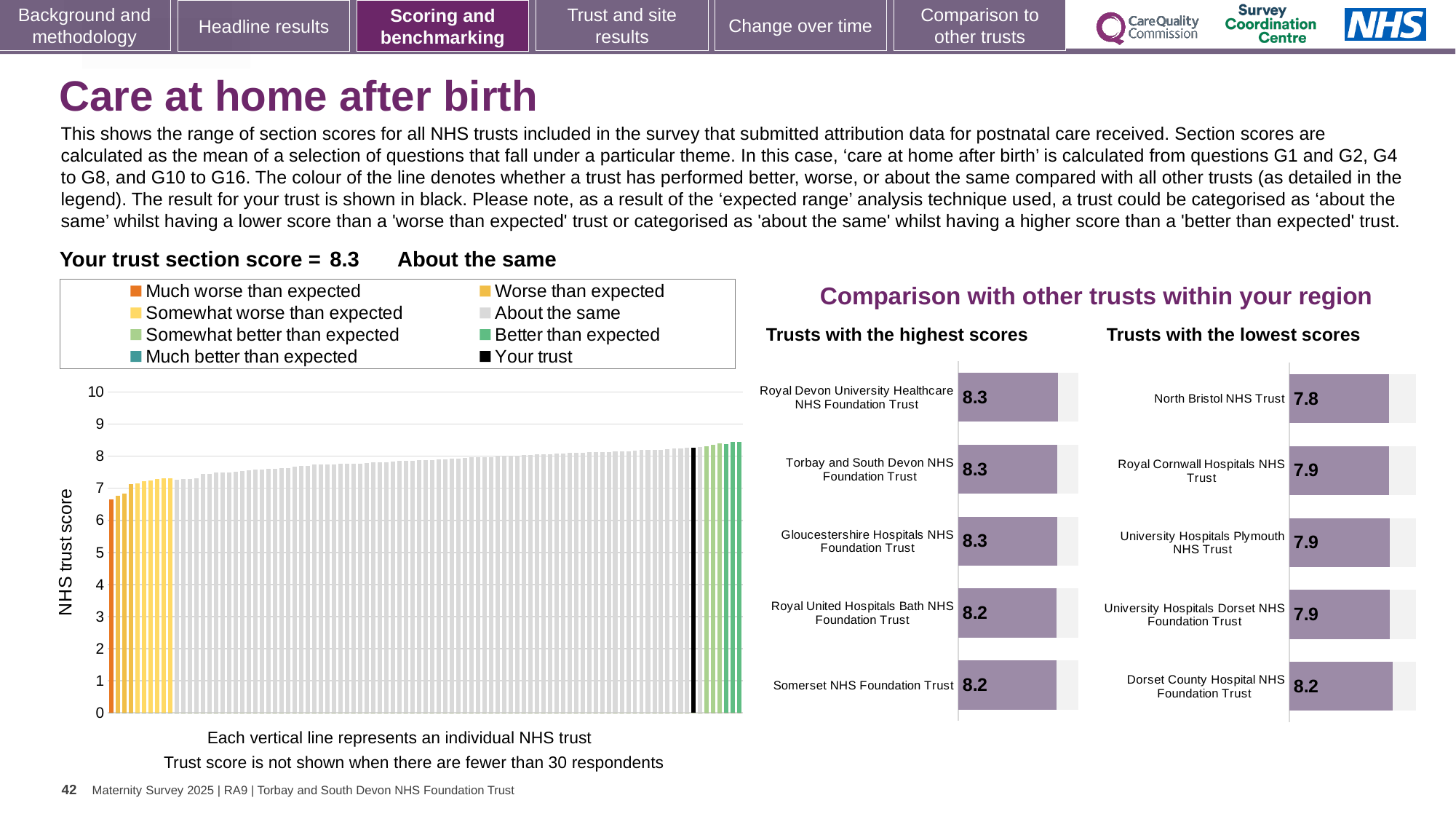
In the 'Trusts with the highest scores' chart, what is the score for Royal United Hospitals Bath NHS Foundation Trust? 8.2 How many entries does the legend above the large chart on the left list? 8 In the 'Trusts with the lowest scores' chart, what is the difference between the scores of Dorset County Hospital NHS Foundation Trust and North Bristol NHS Trust? 0.4 How many trusts are listed in the 'Trusts with the highest scores' chart? 5 In the 'Trusts with the lowest scores' chart, what is the score for North Bristol NHS Trust? 7.8 In the large chart on the left, is the value of the lowest bar greater or less than 7? less In the 'Trusts with the lowest scores' chart, what is the score for University Hospitals Plymouth NHS Trust? 7.9 Which has the higher score: Somerset NHS Foundation Trust in the 'Trusts with the highest scores' chart or North Bristol NHS Trust in the 'Trusts with the lowest scores' chart? Somerset NHS Foundation Trust In the 'Trusts with the lowest scores' chart, which trust has the highest score? Dorset County Hospital NHS Foundation Trust What type of chart is the large chart on the left showing NHS trust scores? Bar chart In the large chart on the left, is the value of the black bar (your trust) greater or less than 8? greater In the 'Trusts with the lowest scores' chart, which trust has the lowest score? North Bristol NHS Trust